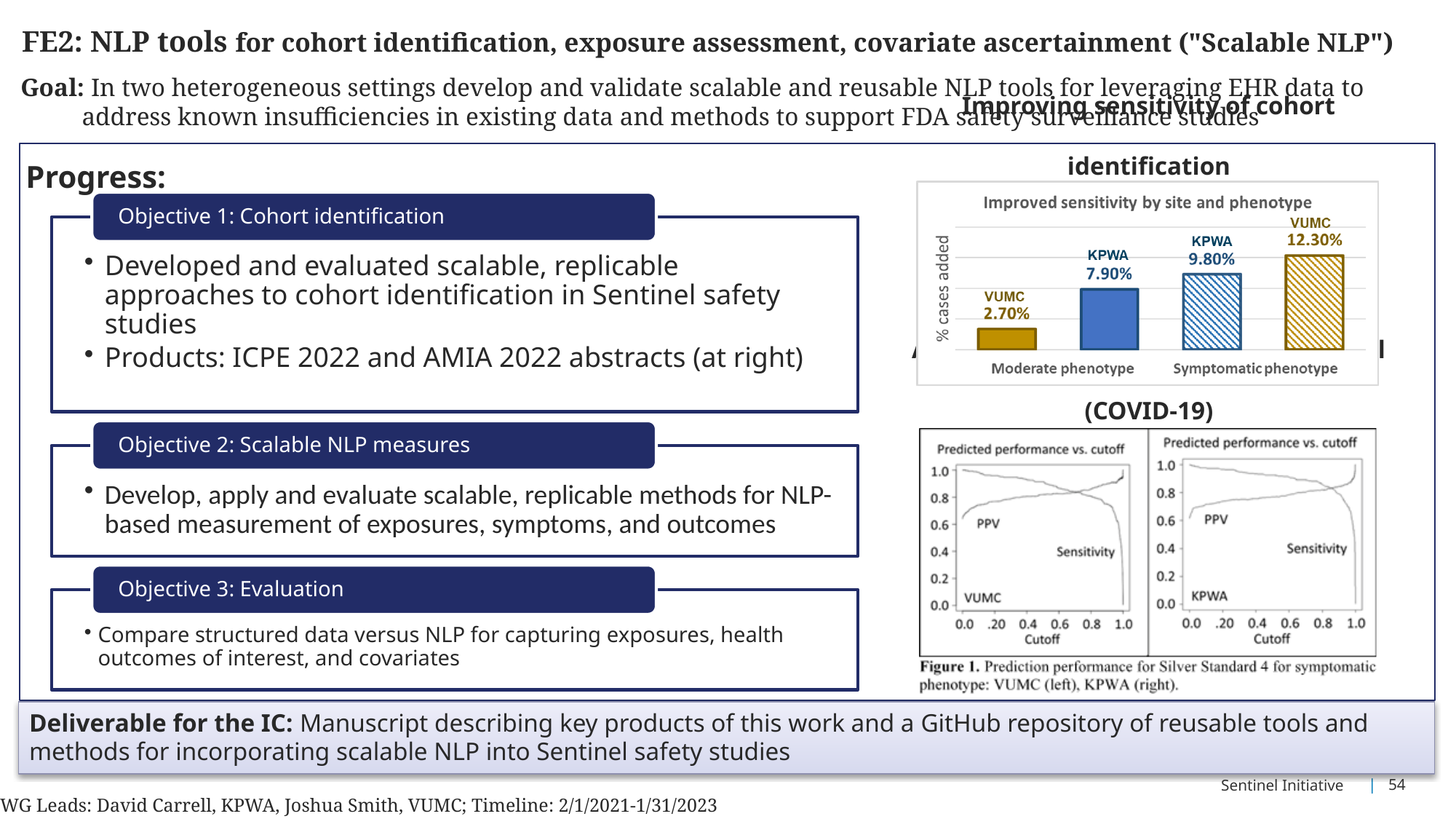
In the 'Improved sensitivity by site and phenotype' chart, which bar has the lowest value? VUMC, Moderate phenotype (2.70%) In the 'Improved sensitivity by site and phenotype' chart, what is the value for KPWA in the Moderate phenotype? 7.90% In the 'Improved sensitivity by site and phenotype' chart, what is the value for KPWA in the Symptomatic phenotype? 9.80% How many bars are shown in the 'Improved sensitivity by site and phenotype' chart? 4 In the 'Improved sensitivity by site and phenotype' chart, which is larger for the Moderate phenotype: VUMC or KPWA? KPWA What kind of chart is 'Improved sensitivity by site and phenotype'? Bar chart What is the y-axis label of the 'Improved sensitivity by site and phenotype' chart? % cases added In the 'Improved sensitivity by site and phenotype' chart, what is the difference between the KPWA values for the Symptomatic and Moderate phenotypes? 1.90% In the 'Predicted performance vs. cutoff' charts at the bottom right, which two measures are plotted against Cutoff? PPV and Sensitivity In the 'Improved sensitivity by site and phenotype' chart, which bar has the highest value? VUMC, Symptomatic phenotype (12.30%) In the 'Improved sensitivity by site and phenotype' chart, what is the value for VUMC in the Moderate phenotype? 2.70% In the 'Improved sensitivity by site and phenotype' chart, what is the difference between the VUMC values for the Symptomatic and Moderate phenotypes? 9.60%